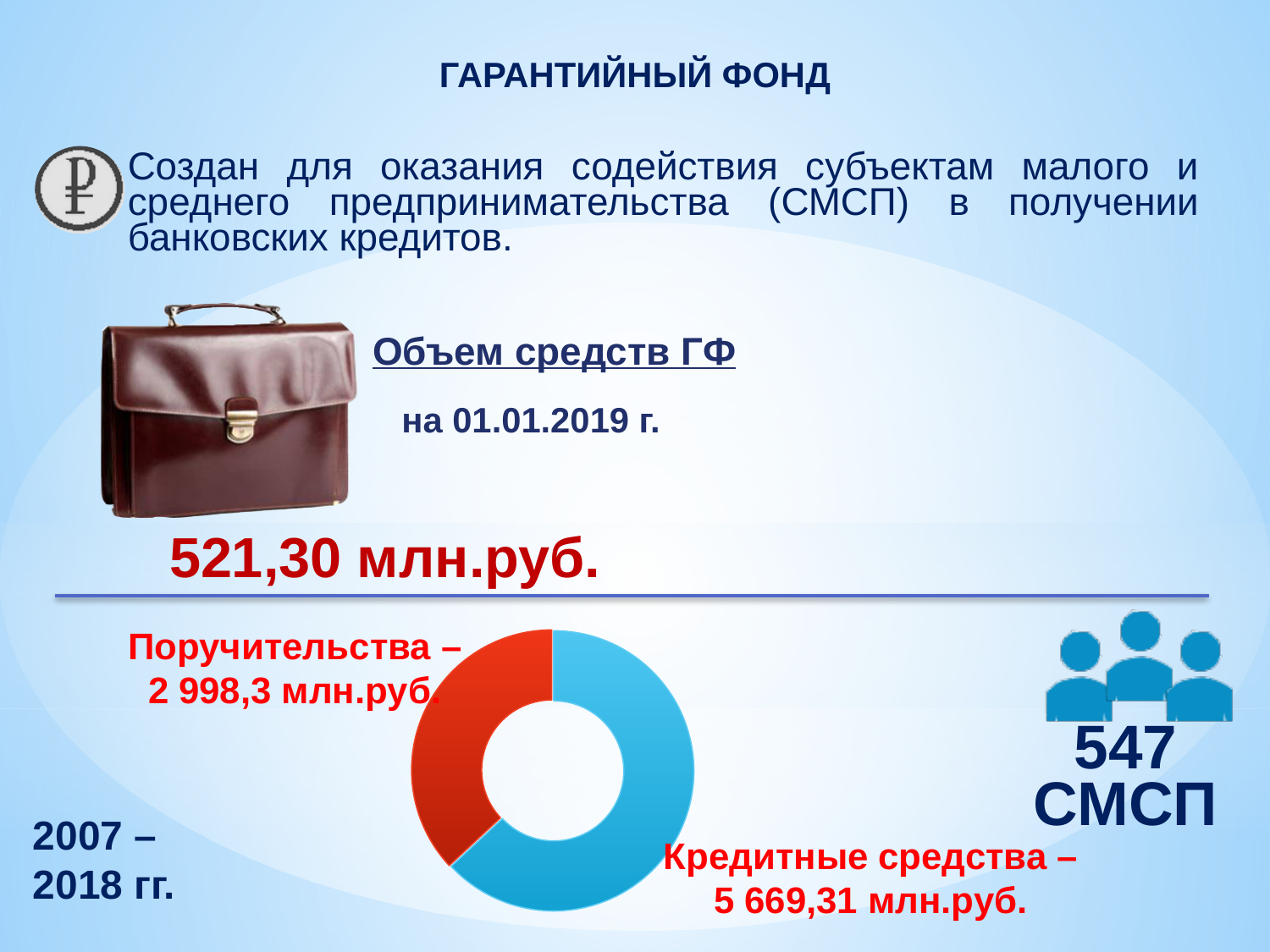
What is the difference between the Кредитные средства value and the Поручительства value in the donut chart? 2 671,01 млн.руб. What value is shown for Кредитные средства in the donut chart? 5 669,31 млн.руб. What kind of chart is shown at the bottom of the slide? Donut (pie) chart How many segments does the donut chart have? 2 What colour is the Кредитные средства segment of the donut chart? Blue What value is shown for Поручительства in the donut chart? 2 998,3 млн.руб. Which segment of the donut chart has the smaller value? Поручительства Which segment of the donut chart has the larger value? Кредитные средства What period does the donut chart cover, according to the label on the slide? 2007 – 2018 гг. Is the value for Кредитные средства larger or smaller than the value for Поручительства? larger What colour is the Поручительства segment of the donut chart? Red